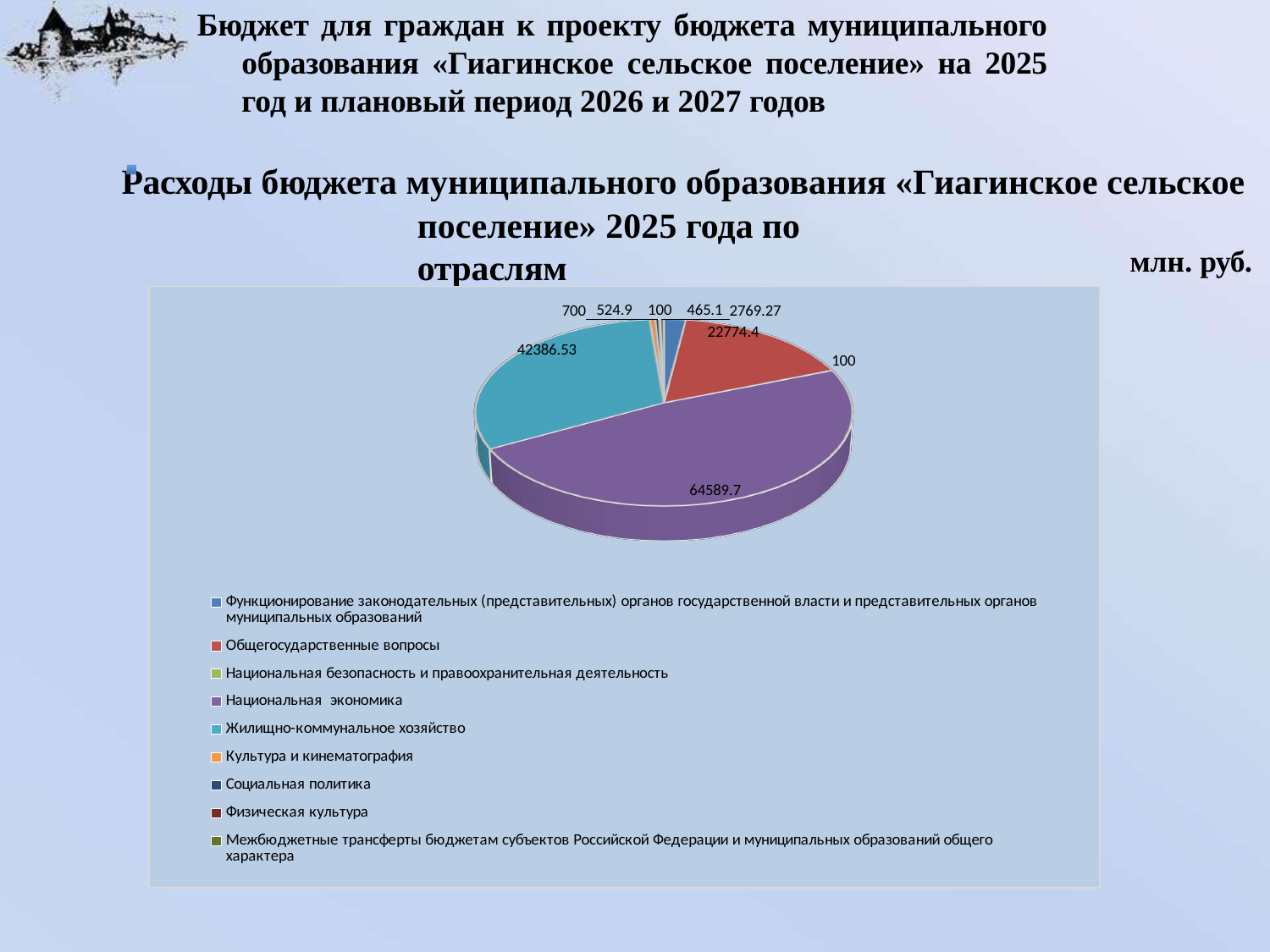
What kind of chart is shown on the slide? pie chart What is the value shown for Национальная экономика? 64589.7 How many categories does the legend of the pie chart list? 9 What is the difference between the values for Национальная экономика and Жилищно-коммунальное хозяйство? 22203.17 Which year's budget expenditures does the chart title refer to? 2025 What is the value shown for Функционирование законодательных (представительных) органов государственной власти и представительных органов муниципальных образований? 2769.27 What unit is indicated for the values in the chart? млн. руб. What is the value shown for Жилищно-коммунальное хозяйство? 42386.53 Which category has the largest slice in the pie chart? Национальная экономика What is the value shown for Общегосударственные вопросы? 22774.4 Which is larger: the value for Общегосударственные вопросы or the value for Жилищно-коммунальное хозяйство? Жилищно-коммунальное хозяйство Which is larger: the value for Национальная экономика or the value for Жилищно-коммунальное хозяйство? Национальная экономика